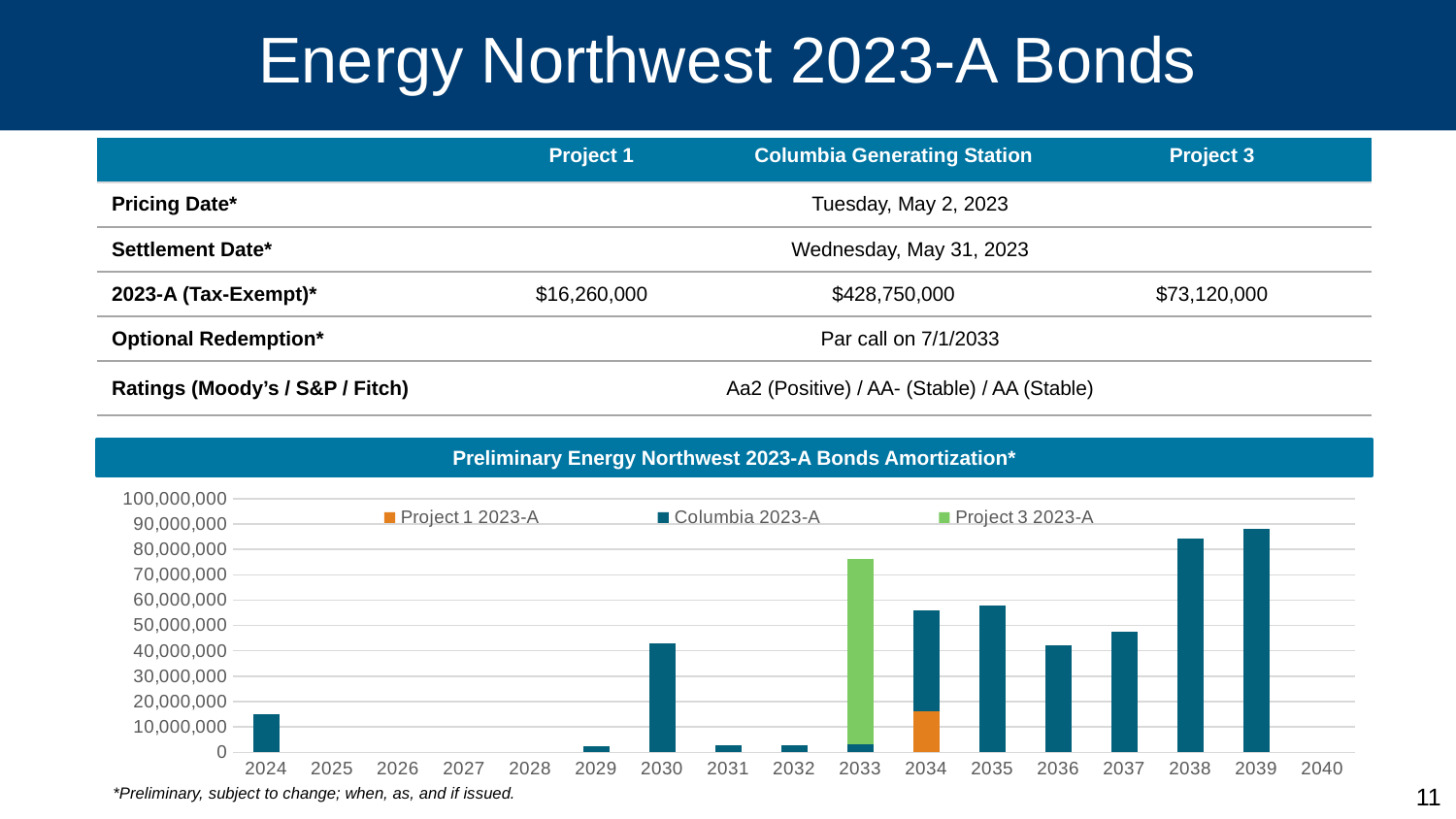
What colour represents the Columbia 2023-A series in the amortization chart? Dark blue Is the total bar for 2036 in the amortization chart greater or less than 50,000,000? less In which year does the Project 1 2023-A series appear in the amortization chart? 2034 In the amortization chart, which year has the larger total bar, 2035 or 2036? 2035 Which year has the tallest total bar in the amortization chart? 2039 How many years are labeled on the x axis of the amortization chart? 17 Is the total bar for 2030 in the amortization chart greater or less than 30,000,000? greater Is the total bar for 2024 in the amortization chart greater or less than 20,000,000? less What kind of chart is shown under 'Preliminary Energy Northwest 2023-A Bonds Amortization*'? Stacked bar chart How many series does the legend of the amortization chart list? 3 In which year does the Project 3 2023-A series appear in the amortization chart? 2033